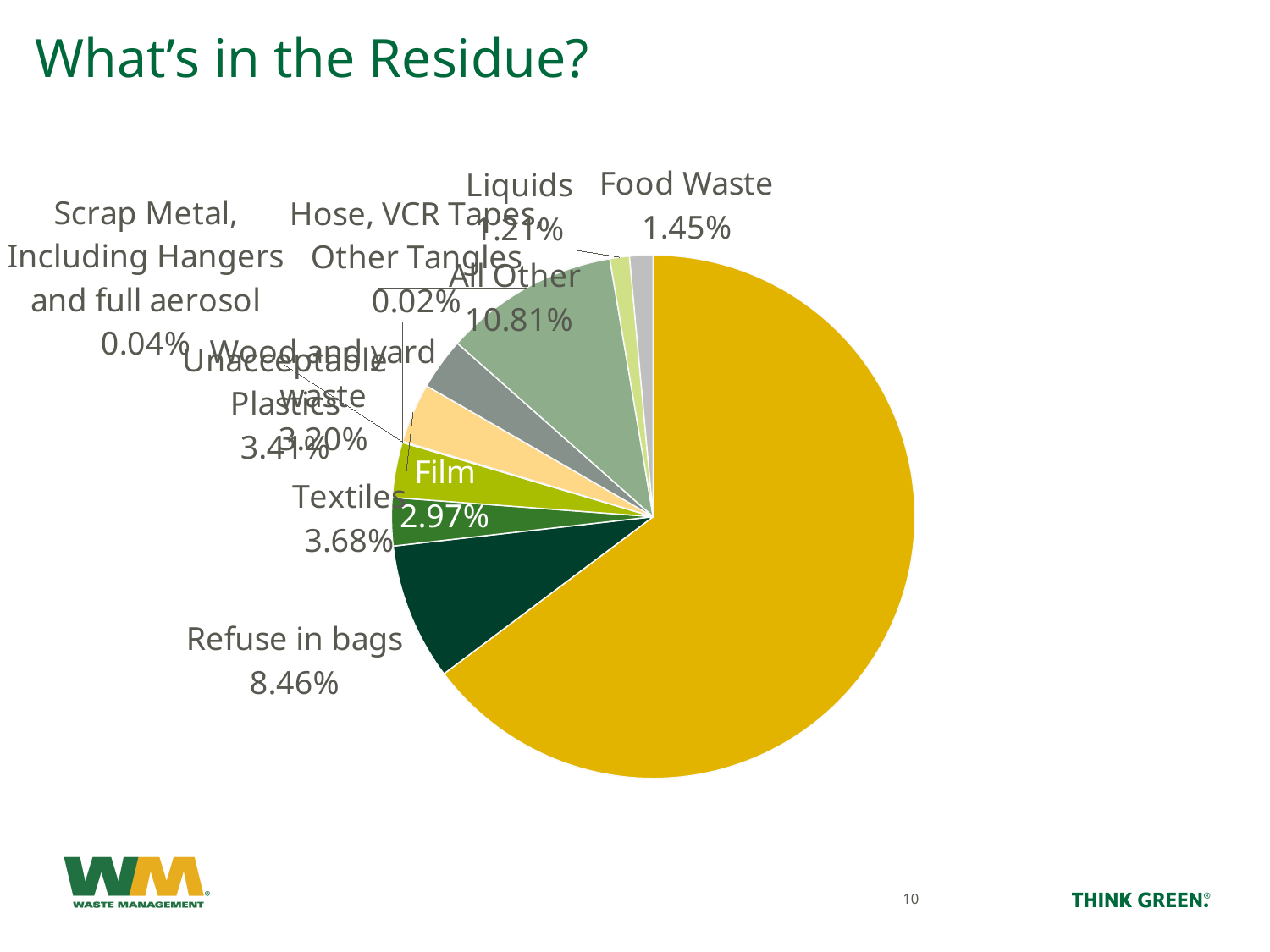
What percentage is shown for Liquids? 1.21% What is the difference between the All Other and Refuse in bags percentages? 2.35% What percentage is labelled for Film? 2.97% What percentage of the residue is Refuse in bags? 8.46% What kind of chart is shown on the slide? pie chart What is the value shown for Food Waste? 1.45% Which is larger, Refuse in bags or All Other? All Other What is the value shown for Textiles? 3.68% Which labelled category has the smallest percentage? Hose, VCR Tapes, Other Tangles What percentage does the All Other slice represent? 10.81% Which is larger, Food Waste or Liquids? Food Waste What is the title of the slide containing the pie chart? What's in the Residue?